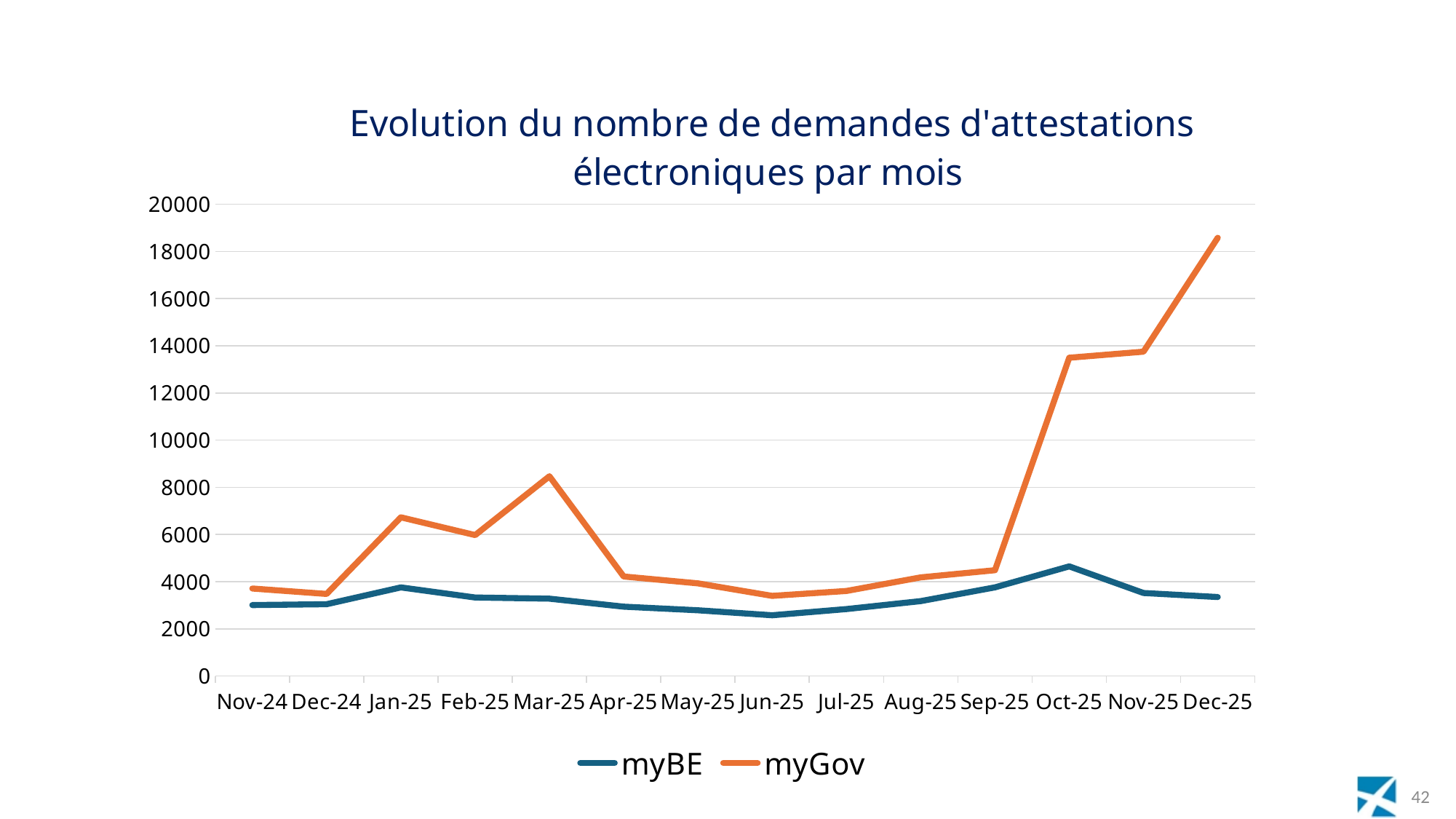
Is the value for myGov in Dec-25 greater or less than 18000? greater Is the value for myGov in Jan-25 greater or less than 6000? greater Is the value for myGov in Oct-25 greater or less than 12000? greater Which series has the larger value in Dec-25, myBE or myGov? myGov Does the myGov series rise or fall from Sep-25 to Dec-25? rise What kind of chart is shown on the slide? line chart In which month does the myBE series reach its lowest value? Jun-25 How many months are plotted along the x axis? 14 What is the title of the chart? Evolution du nombre de demandes d'attestations électroniques par mois How many series does the legend list? 2 In which month does the myGov series reach its highest value? Dec-25